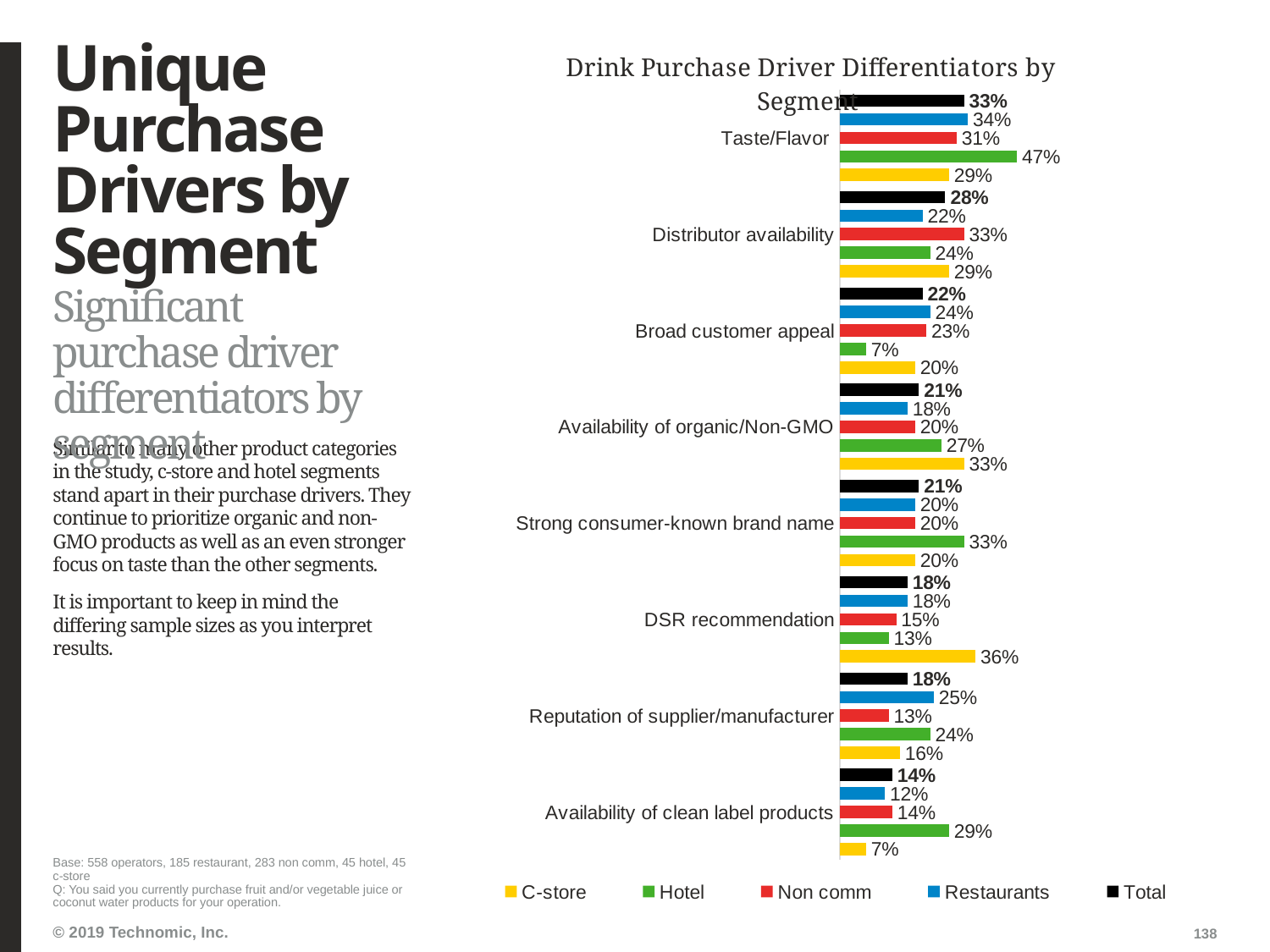
What kind of chart is shown on the slide? Bar chart Which colour represents the Hotel series in the legend? Green What is the Total value for Availability of clean label products? 14% How many series does the legend list? 5 How many categories are shown on the chart? 8 For Availability of organic/Non-GMO, which is larger: the C-store value or the Restaurants value? C-store What is the Non comm value for Distributor availability? 33% What is the Hotel value for Taste/Flavor? 47% Which category has the lowest Hotel value? Broad customer appeal What is the difference between the Hotel and C-store values for Taste/Flavor? 18% Which category has the highest Total value? Taste/Flavor What is the C-store value for DSR recommendation? 36%